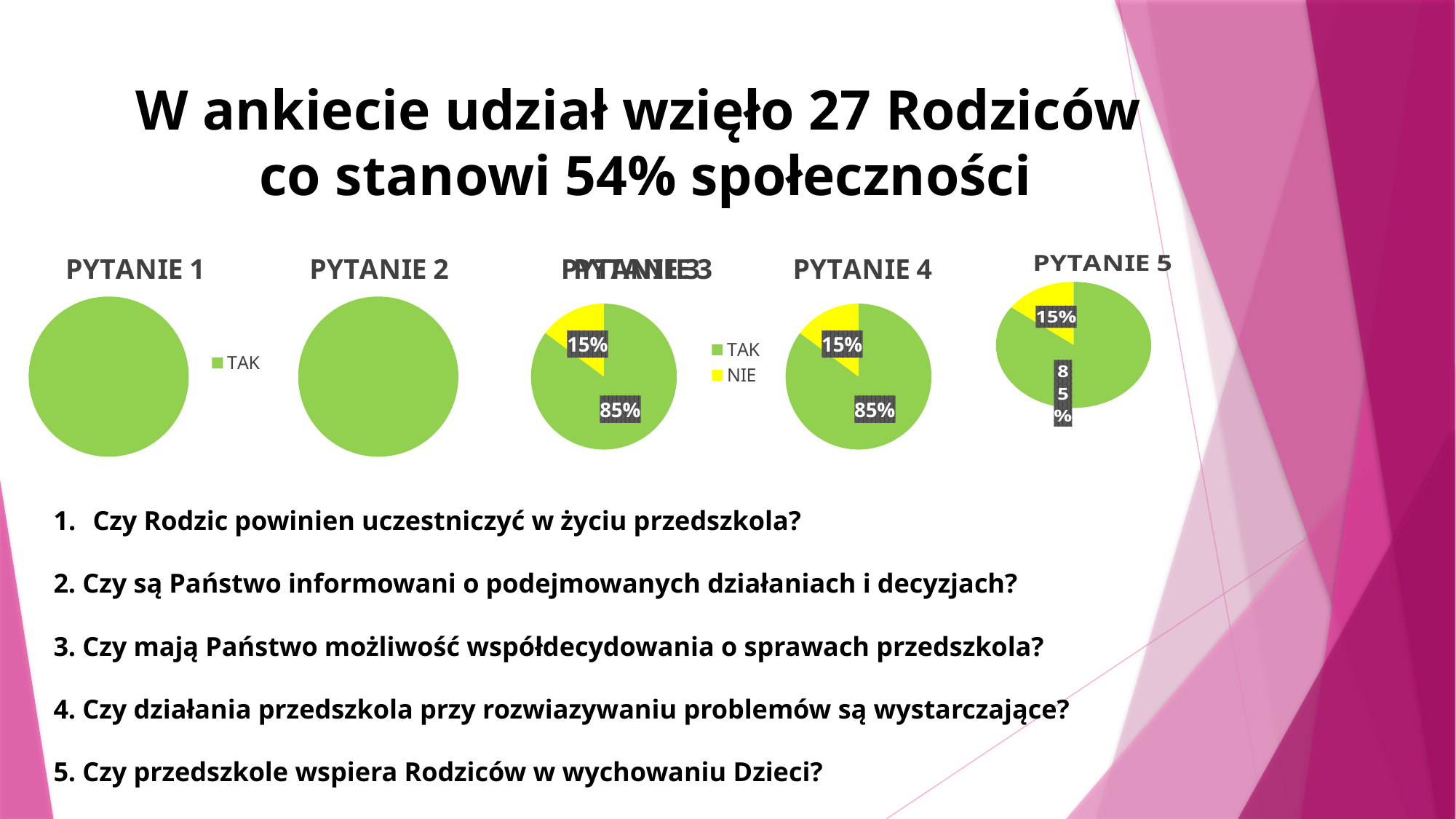
In the PYTANIE 4 pie chart, what percentage is shown for the green slice? 85% What is the only legend entry shown next to the PYTANIE 1 pie chart? TAK In the PYTANIE 3 pie chart, what share is labelled for the TAK slice? 85% How many pie charts are shown on the slide? 5 In the PYTANIE 4 pie chart, what percentage is shown for the yellow slice? 15% In the PYTANIE 3 pie chart, what share is labelled for the NIE slice? 15% What kind of chart is used for PYTANIE 1? pie chart In the PYTANIE 3 pie chart, what is the difference between the TAK and NIE shares? 70% In the PYTANIE 4 pie chart, which slice is larger, TAK or NIE? TAK In the PYTANIE 5 pie chart, what percentage is shown for the yellow slice? 15% How many entries does the legend next to the PYTANIE 3 pie chart list? 2 Which colour represents NIE in the legend next to the PYTANIE 3 pie chart? yellow